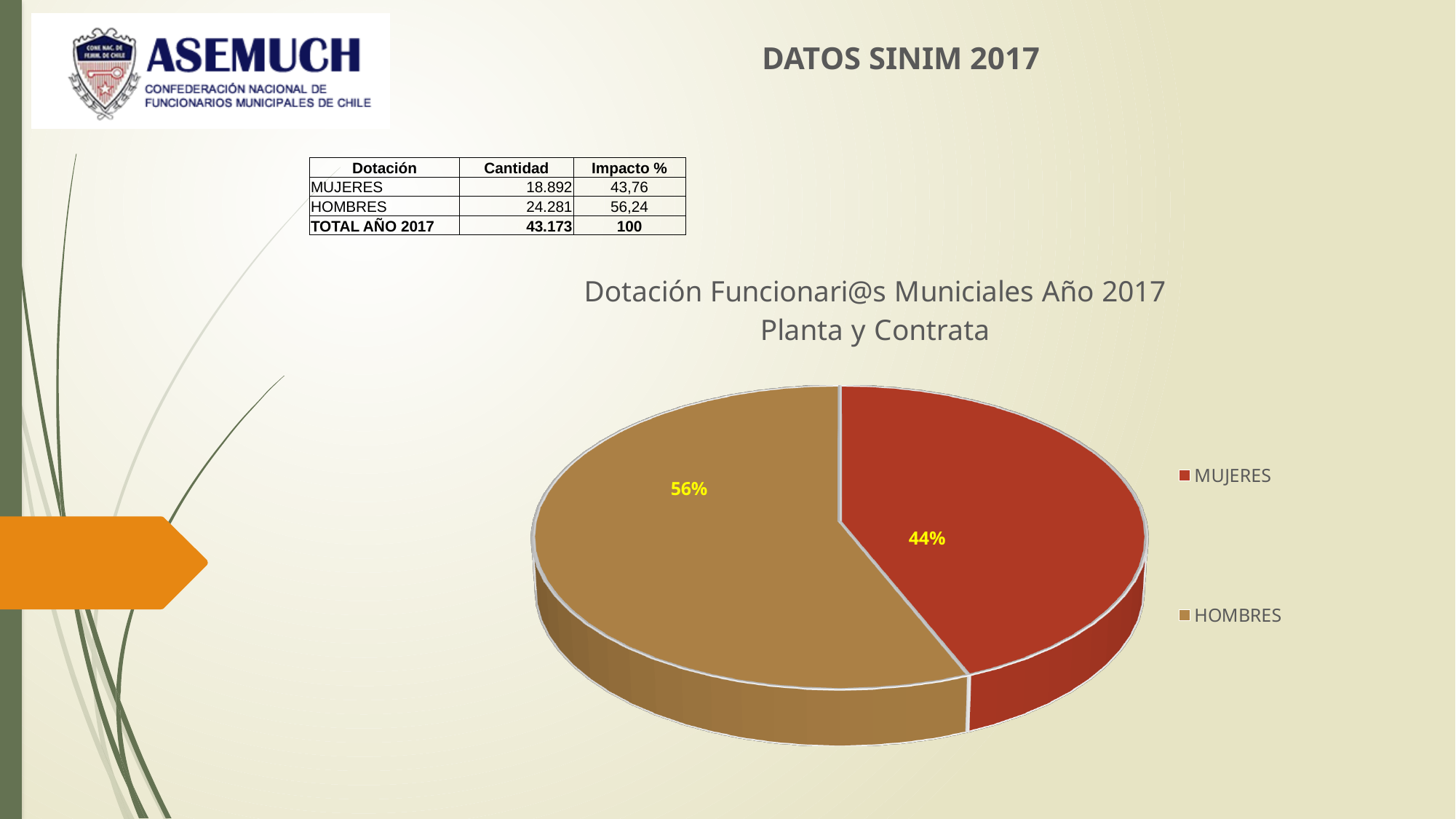
Which slice is larger in the pie chart, MUJERES or HOMBRES? HOMBRES How many slices does the pie chart have? 2 What share of the pie does the HOMBRES slice represent? 56% Which colour represents MUJERES in the pie chart? Red How many entries does the pie chart's legend list? 2 Which category has the largest slice in the pie chart? HOMBRES What type of chart is shown on the slide? Pie chart What percentage does the pie chart show for MUJERES? 44% What is the difference in percentage points between the HOMBRES and MUJERES slices in the pie chart? 12% What percentage does the pie chart show for HOMBRES? 56% Which category has the smallest slice in the pie chart? MUJERES What is the title of the pie chart? Dotación Funcionari@s Municiales Año 2017 Planta y Contrata